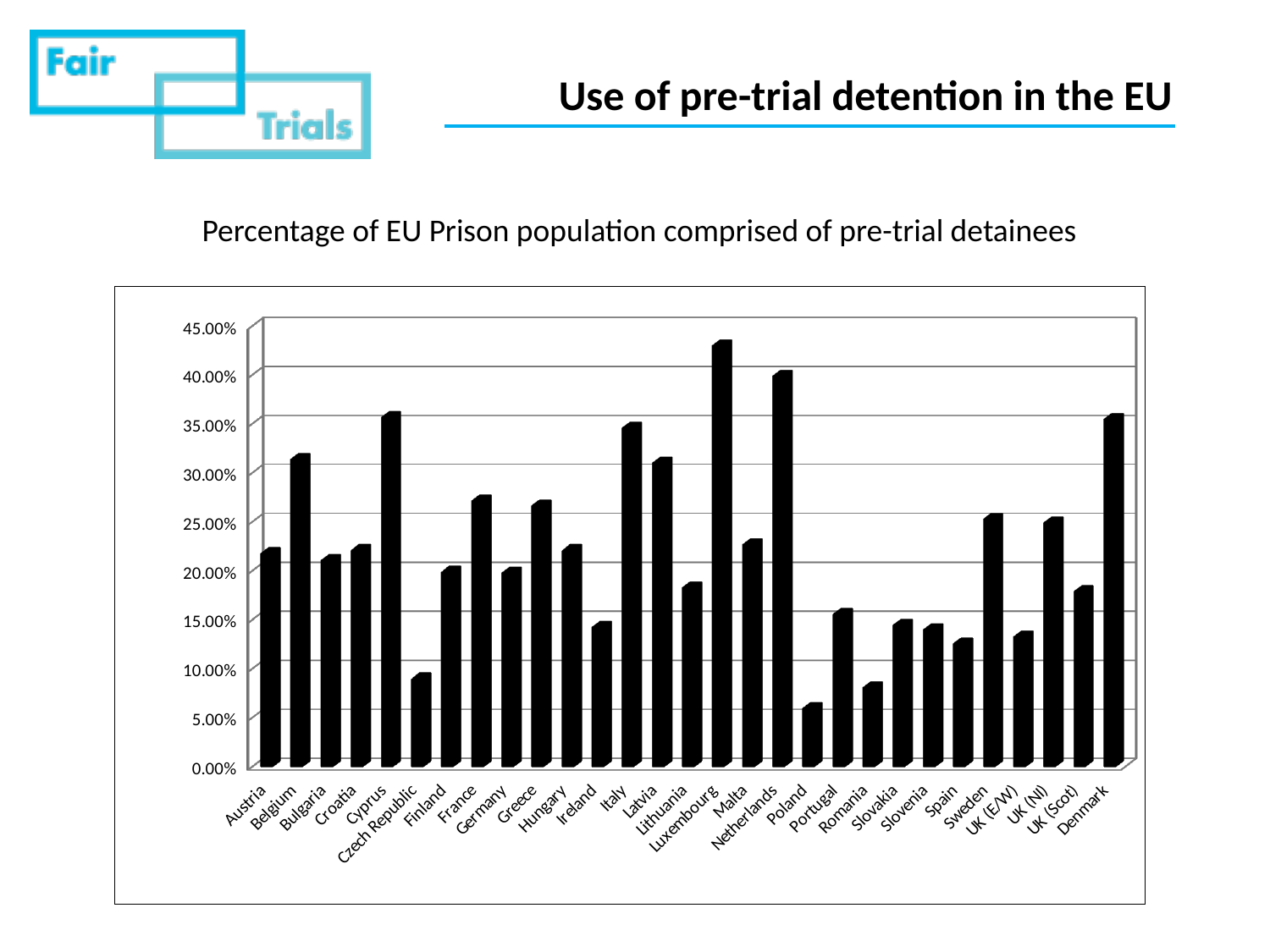
Is the value for Netherlands greater or less than 35.00%? greater Is the value for Poland greater or less than 10.00%? less Which country has the lowest percentage of pre-trial detainees in its prison population? Poland What kind of chart is shown on the slide? bar chart Is the value for Belgium greater or less than 30.00%? greater Which country has the highest percentage of pre-trial detainees in its prison population? Luxembourg Which has a higher value, Netherlands or Italy? Netherlands How many countries are shown on the x axis of the chart? 29 Which has a higher value, Belgium or Austria? Belgium What is the title of the chart? Percentage of EU Prison population comprised of pre-trial detainees